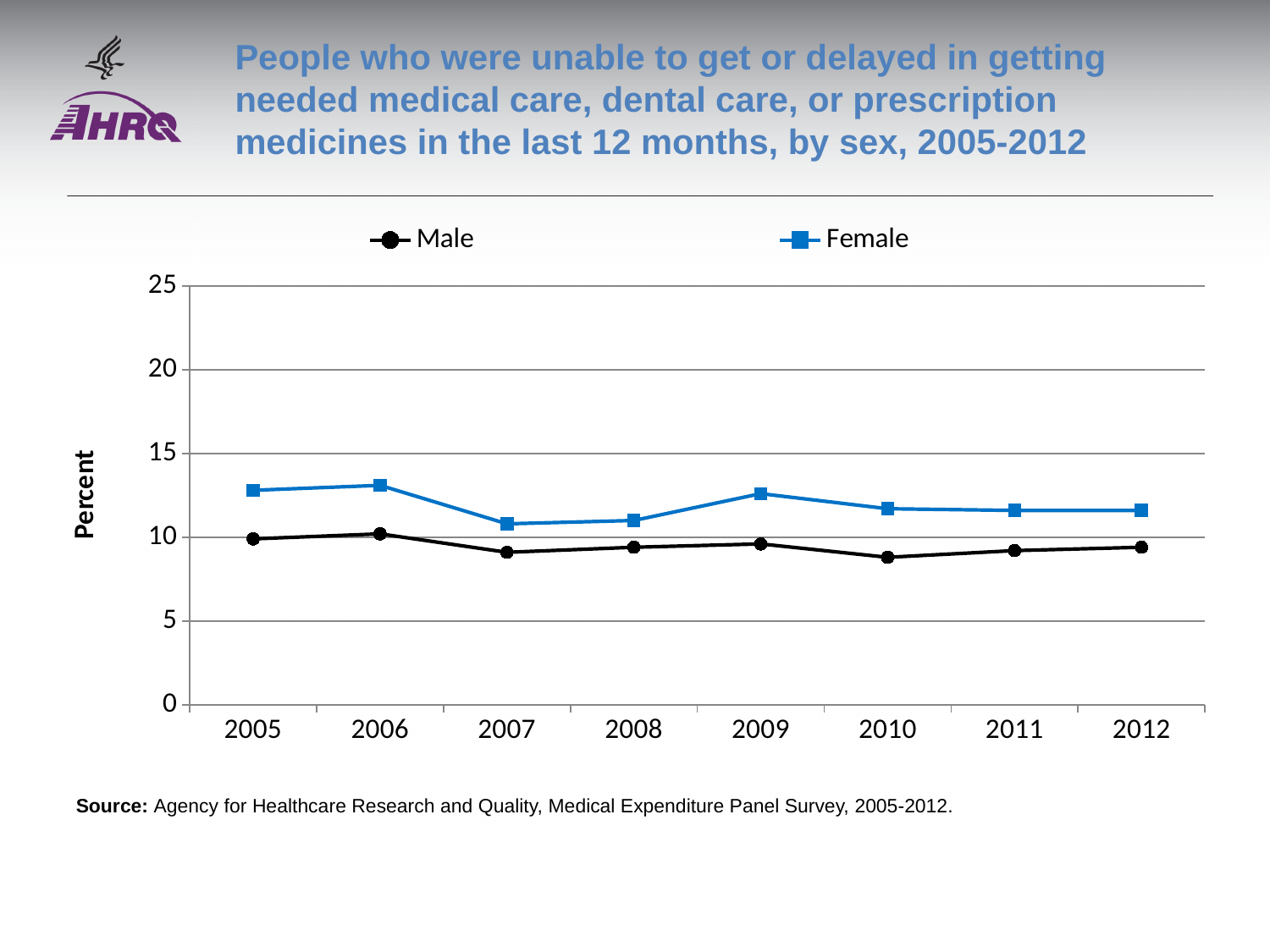
How many series does the legend list? 2 For the Female series, which year has the higher value, 2006 or 2007? 2006 In which year is the Male series at its lowest? 2010 What is the label on the y axis? Percent Is the value for Male in 2007 greater or less than 10? less Does the Female series rise or fall from 2006 to 2007? Fall Is the value for Female in 2006 greater or less than 15? less How many years are plotted along the x axis? 8 Is the value for Female in 2005 greater or less than 10? greater In 2005, which series has the higher value, Male or Female? Female What kind of chart is shown on the slide? Line chart